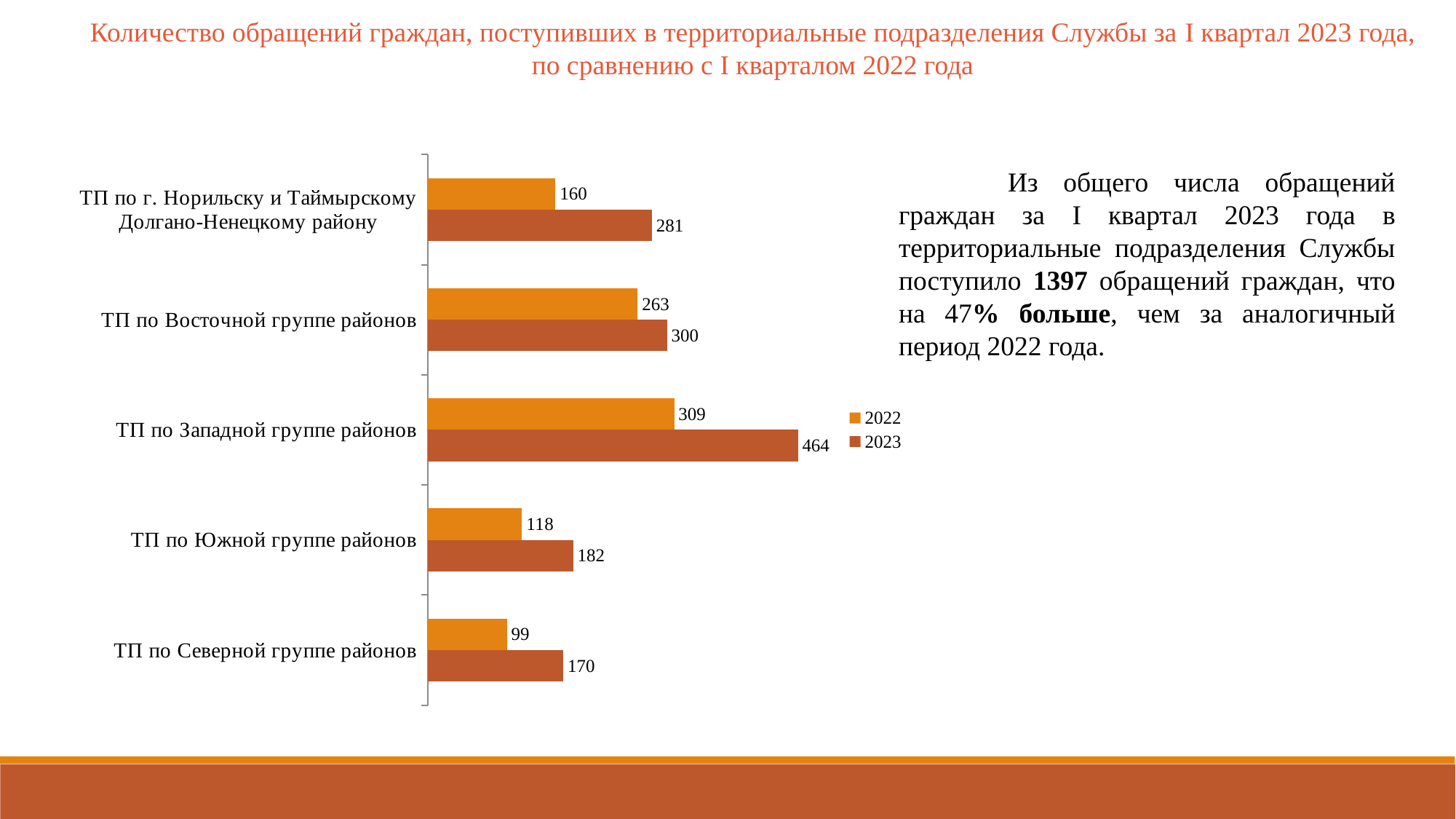
How many series does the legend list? 2 Which is larger: the 2023 value for ТП по Восточной группе районов or the 2023 value for ТП по г. Норильску и Таймырскому Долгано-Ненецкому району? ТП по Восточной группе районов What kind of chart is shown on the slide? Bar chart What is the 2023 value for ТП по Западной группе районов? 464 What is the difference between the 2023 and 2022 values for ТП по Восточной группе районов? 37 What is the 2022 value for ТП по Северной группе районов? 99 Which category has the highest 2023 value? ТП по Западной группе районов What is the 2022 value for ТП по г. Норильску и Таймырскому Долгано-Ненецкому району? 160 What is the difference between the 2023 and 2022 values for ТП по Южной группе районов? 64 Which category has the lowest 2022 value? ТП по Северной группе районов How many categories are shown on the chart? 5 Which series is shown in the darker red-brown colour? 2023